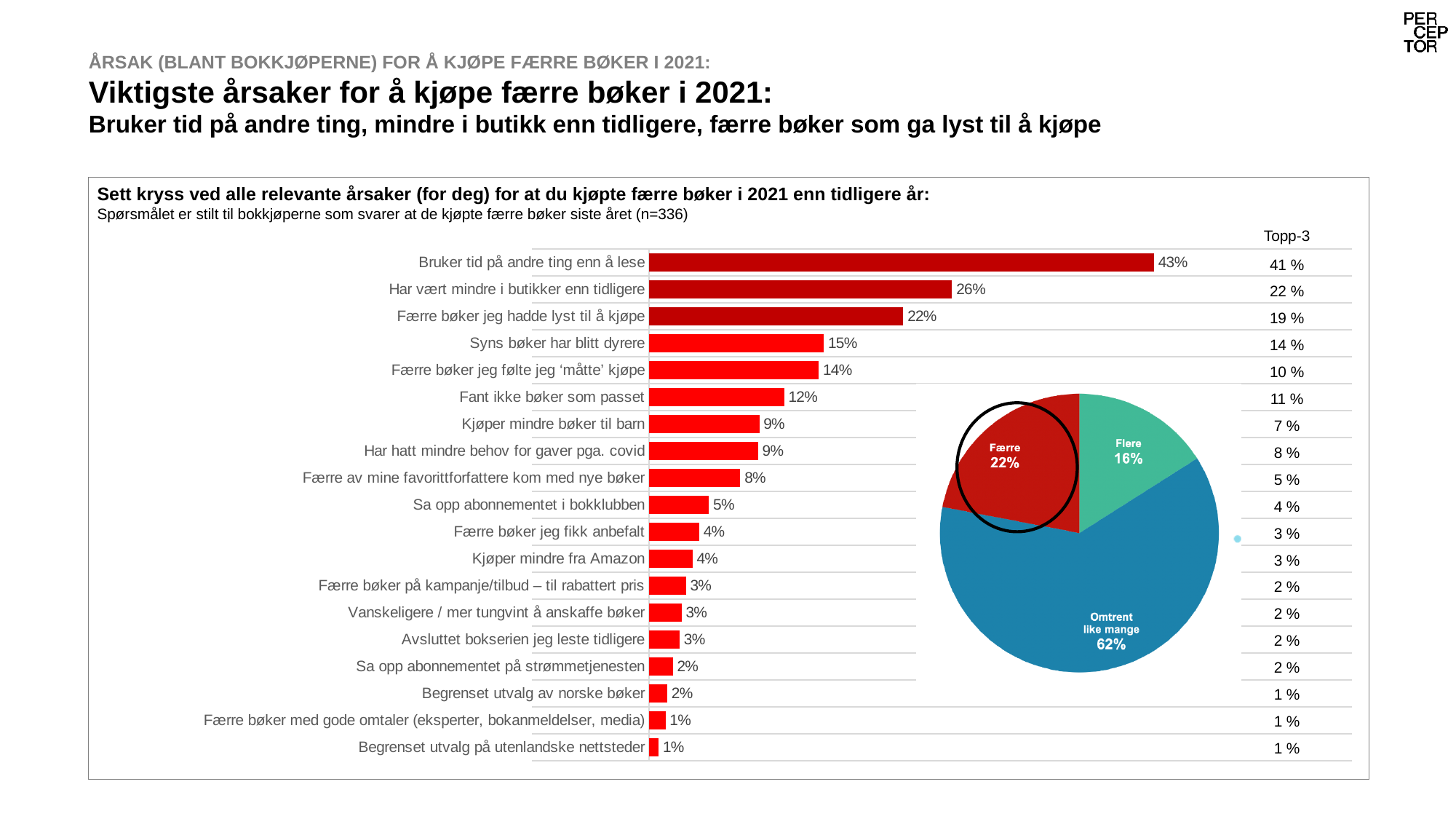
What kind of chart is the chart on the left of the slide? Bar chart In the bar chart, what is the value for "Sa opp abonnementet i bokklubben"? 5% How many slices does the pie chart have? 3 In the pie chart, what is the share for "Flere"? 16% In the pie chart, what is the share for "Omtrent like mange"? 62% In the bar chart, what is the value for "Bruker tid på andre ting enn å lese"? 43% In the bar chart, what is the difference between "Har vært mindre i butikker enn tidligere" and "Færre bøker jeg hadde lyst til å kjøpe"? 4% How many categories does the bar chart show? 19 In the bar chart, which category has the highest value? Bruker tid på andre ting enn å lese In the bar chart, which is larger: "Fant ikke bøker som passet" or "Kjøper mindre bøker til barn"? Fant ikke bøker som passet In the pie chart, which slice is the smallest? Flere In the bar chart, what is the value for "Syns bøker har blitt dyrere"? 15%